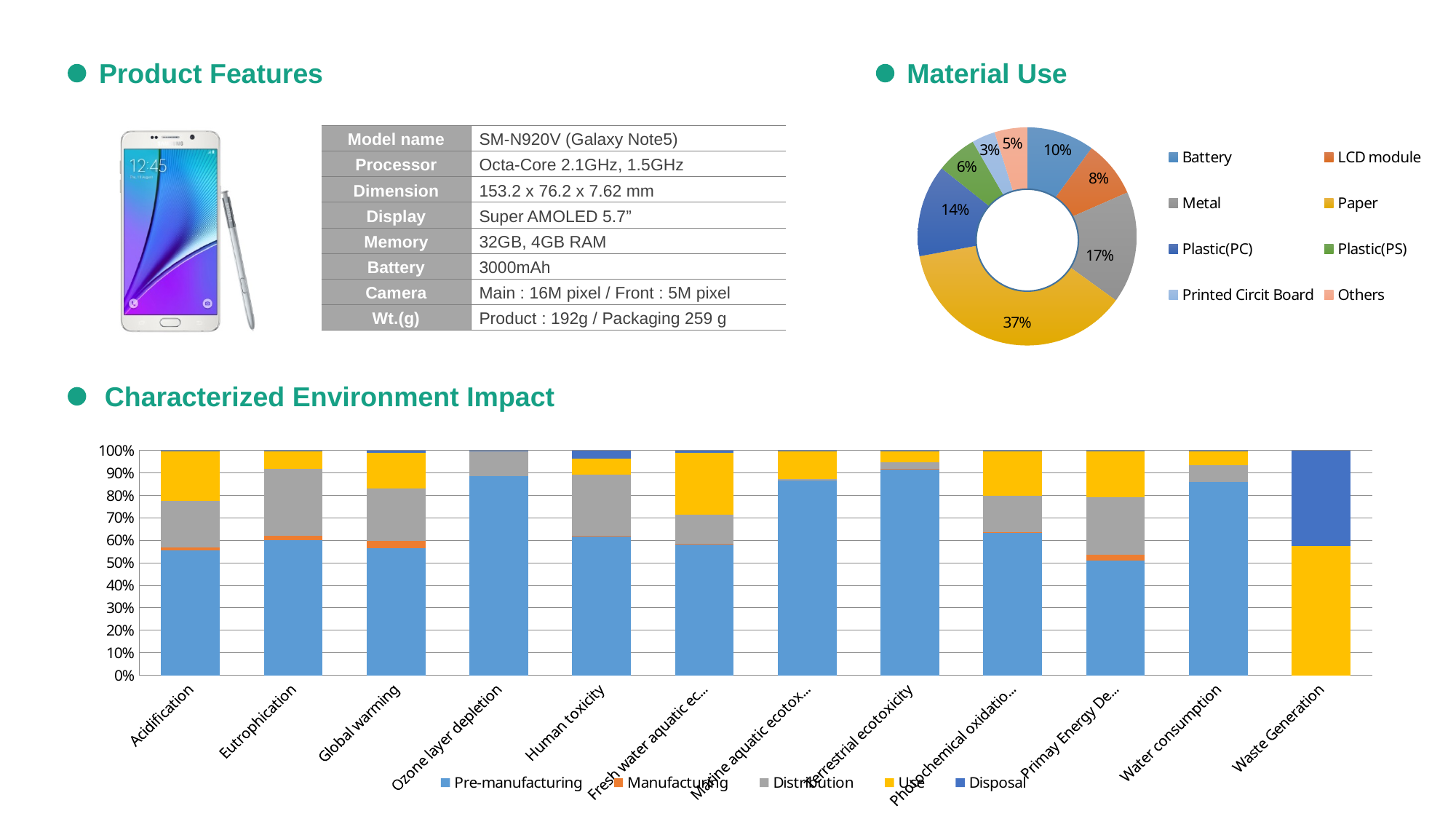
In the Material Use chart, which is larger, the share for LCD module or the share for Plastic(PS)? LCD module How many series does the legend of the Characterized Environment Impact chart list? 5 In the Material Use chart, what is the difference between the Metal share and the Battery share? 7% What kind of chart is the Characterized Environment Impact chart? Stacked bar chart In the Material Use chart, what share does Paper account for? 37% In the Material Use chart, what percentage is shown for Plastic(PC)? 14% In the Characterized Environment Impact chart, is the Pre-manufacturing value for Ozone layer depletion greater or less than 80%? greater In the Material Use chart, which material has the largest share? Paper In the Characterized Environment Impact chart, which series is shown in yellow according to the legend? Use In the Material Use chart, which material has the smallest share? Printed Circit Board How many entries does the legend of the Material Use chart list? 8 How many categories are shown on the x axis of the Characterized Environment Impact chart? 12